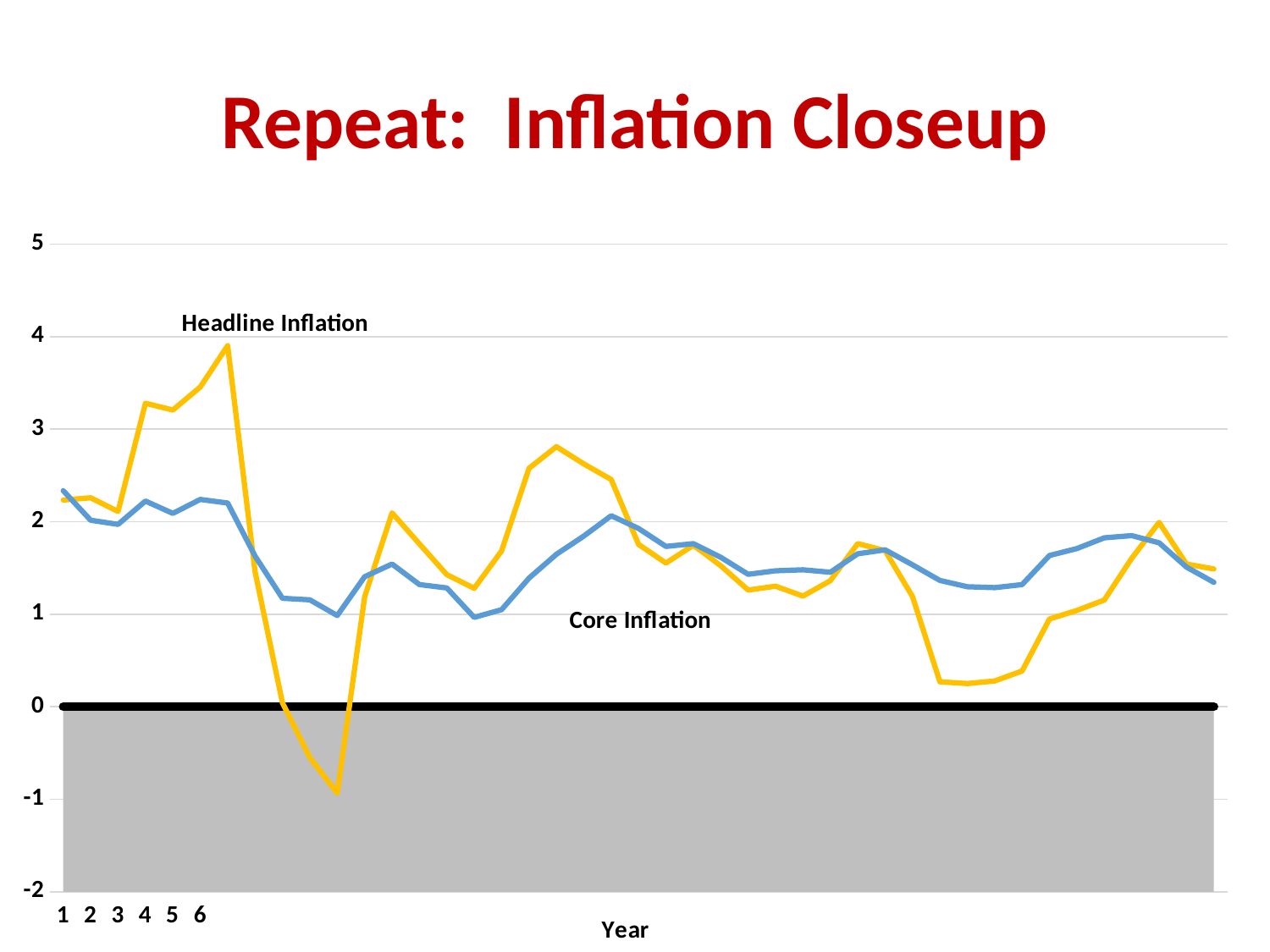
What is the title of the slide? Repeat: Inflation Closeup Is the value of Headline Inflation at year 6 greater or less than 3? greater Is the value of Headline Inflation at year 4 greater or less than 3? greater Does Headline Inflation rise or fall between year 3 and year 4? rise Is the value of Core Inflation at year 1 greater or less than 2? greater At year 5, which series has the larger value, Headline Inflation or Core Inflation? Headline Inflation Which series reaches the highest value on the chart? Headline Inflation What kind of chart is shown on the slide? line chart Which series drops below 0 on the chart? Headline Inflation What is the label on the x axis? Year